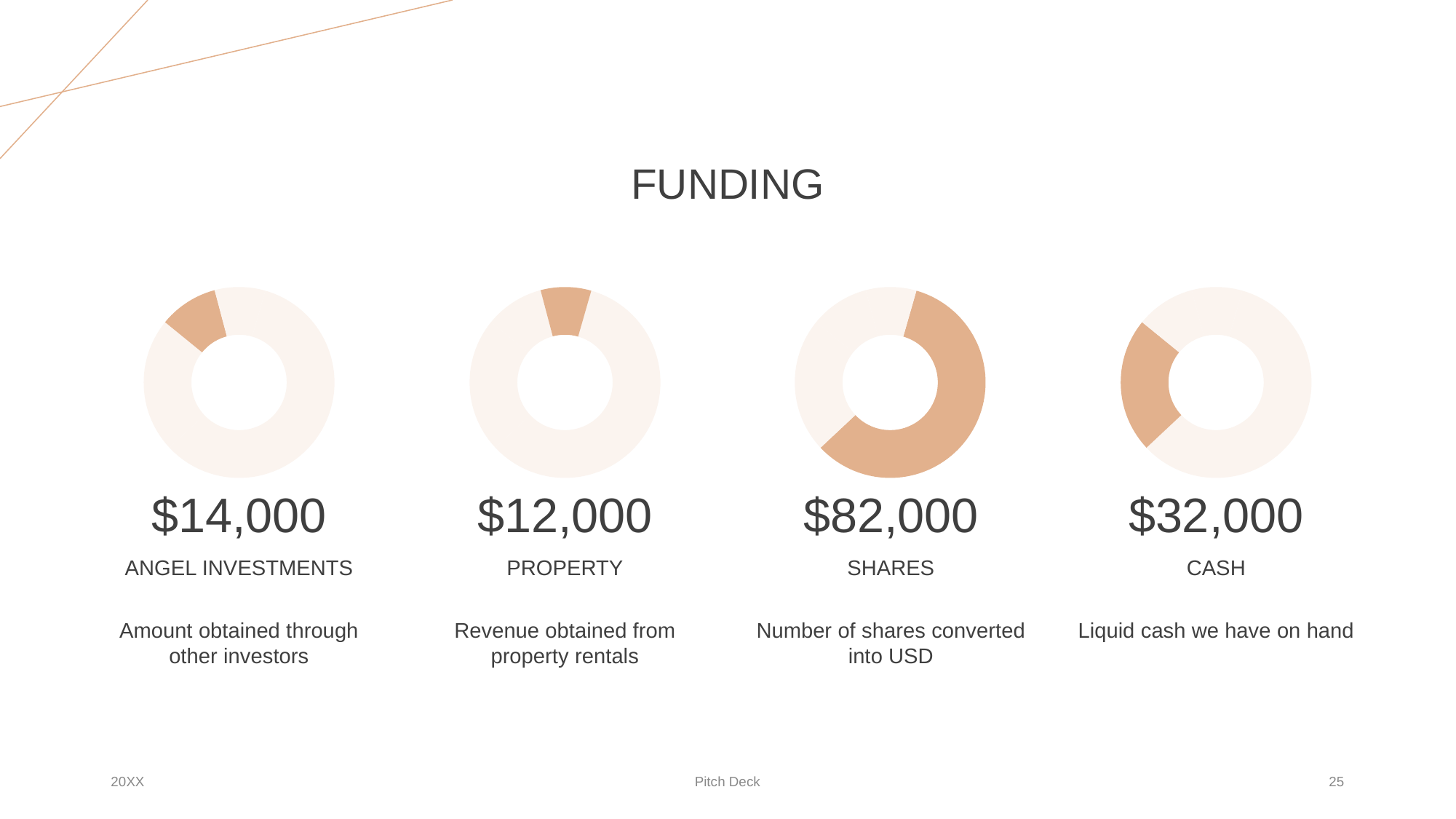
What is the value shown for Cash? $32,000 What is the difference between the Shares value and the Cash value? $50,000 What is the value shown for Angel Investments? $14,000 Which funding category has the highest value? Shares What kind of chart is used for each funding category? Donut chart How many donut charts are shown on the slide? 4 What is the value shown for Shares? $82,000 What is the value shown for Property? $12,000 Which is larger, the value for Cash or the value for Angel Investments? Cash What is the title of the slide containing the charts? FUNDING Which funding category has the lowest value? Property What is the difference between the Angel Investments value and the Property value? $2,000